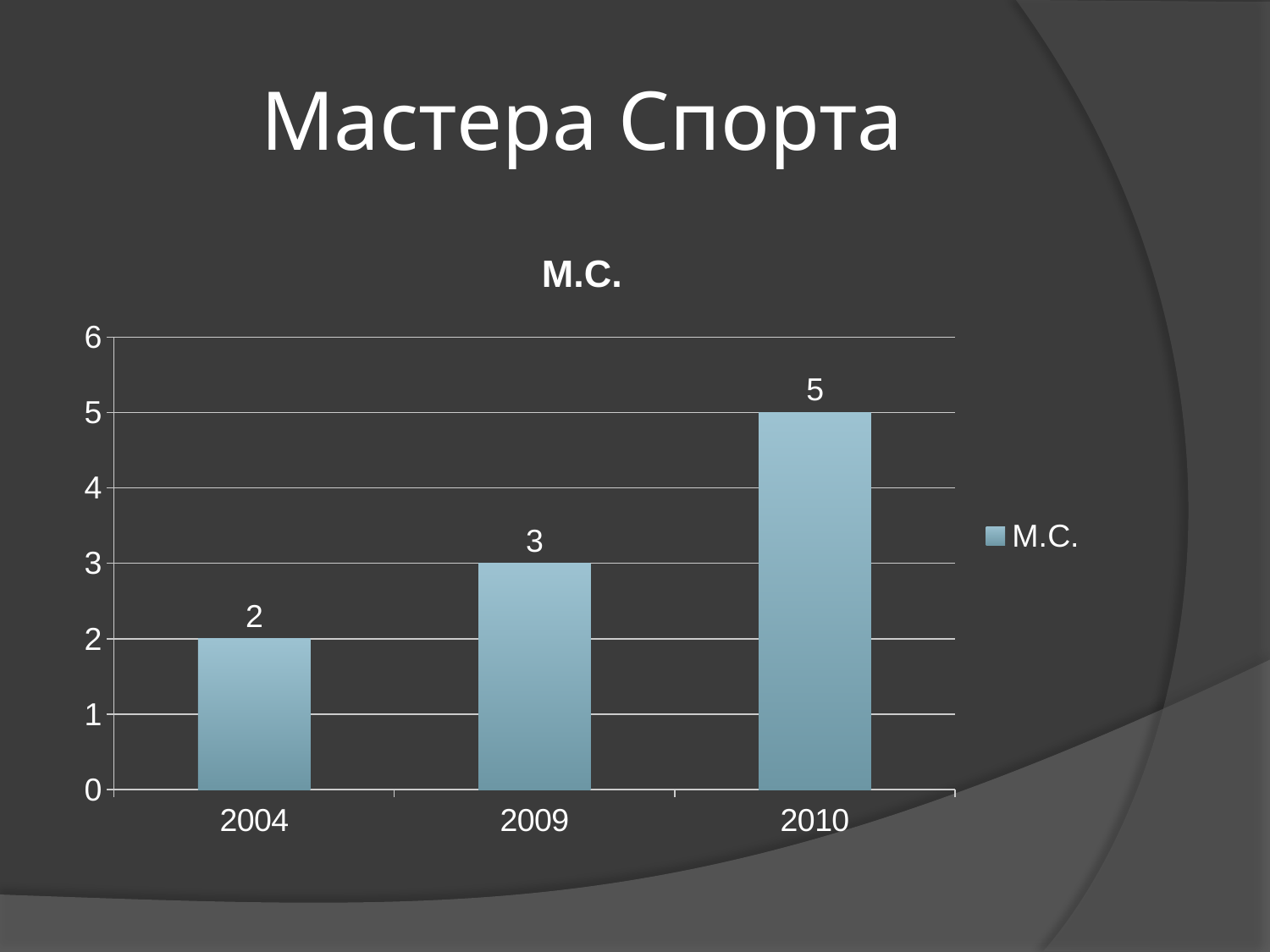
Do the values rise or fall from 2004 to 2010? rise What is the value for 2004? 2 How many years are shown on the x axis? 3 Is the value for 2010 greater or less than 4? greater What is the value for 2009? 3 What kind of chart is shown on the slide? bar chart Which year has the lowest value? 2004 Which is larger, the value for 2009 or the value for 2010? 2010 What is the value for 2010? 5 Which year has the highest value? 2010 What is the difference between the values for 2009 and 2004? 1 What is the difference between the values for 2010 and 2004? 3